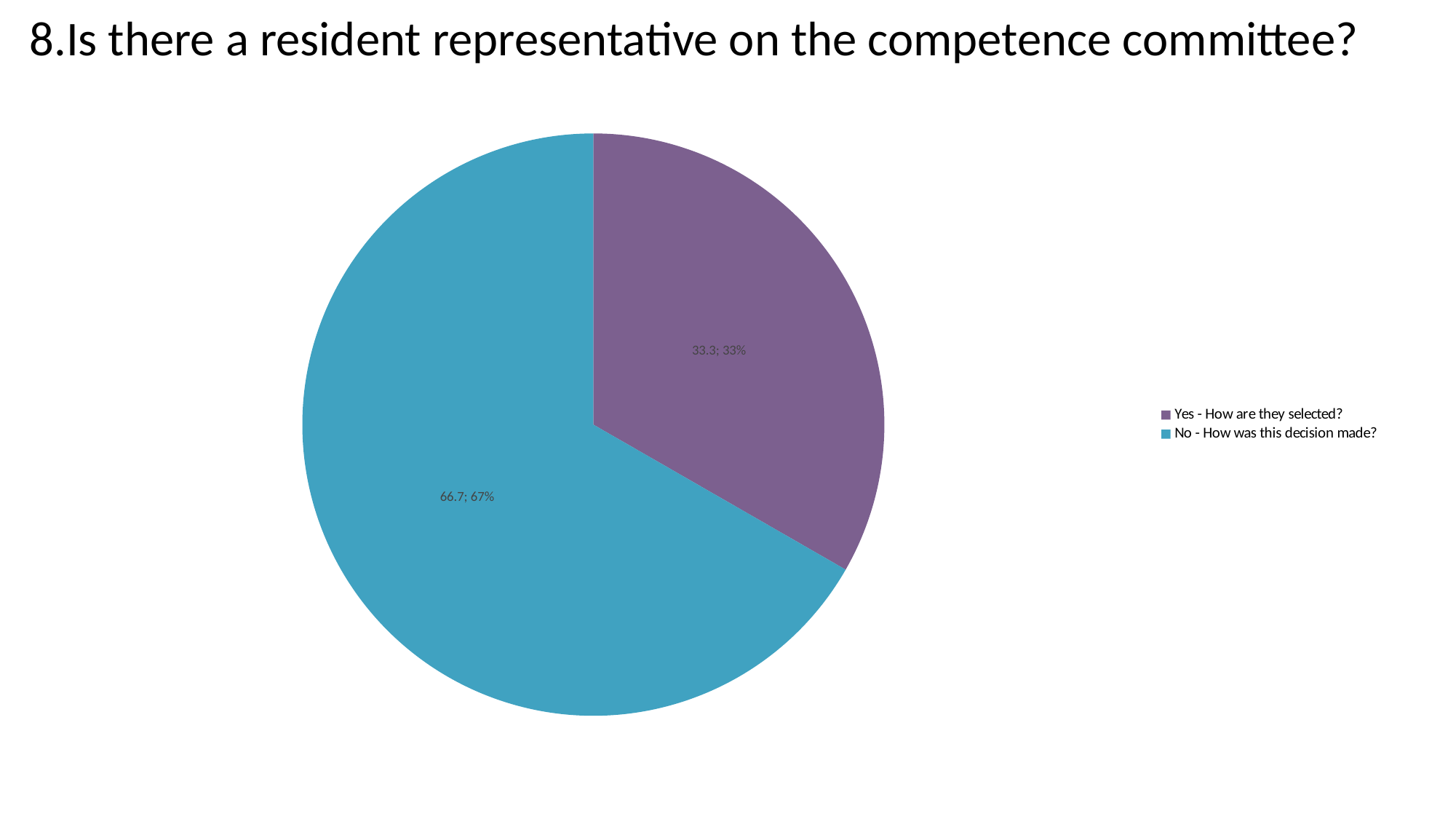
Which is larger, the "Yes - How are they selected?" slice or the "No - How was this decision made?" slice? No - How was this decision made? What colour is the "Yes - How are they selected?" slice? purple What kind of chart is shown on the slide? pie chart What value is labelled on the slice for "No - How was this decision made?"? 66.7 How many slices does the pie chart have? 2 Which slice is the largest in the pie chart? No - How was this decision made? Which slice is the smallest in the pie chart? Yes - How are they selected? What is the difference between the values for "No - How was this decision made?" and "Yes - How are they selected?"? 33.4 How many entries does the legend list? 2 What percentage share of the pie is the "Yes - How are they selected?" slice? 33% What value is labelled on the slice for "Yes - How are they selected?"? 33.3 What percentage share of the pie is the "No - How was this decision made?" slice? 67%